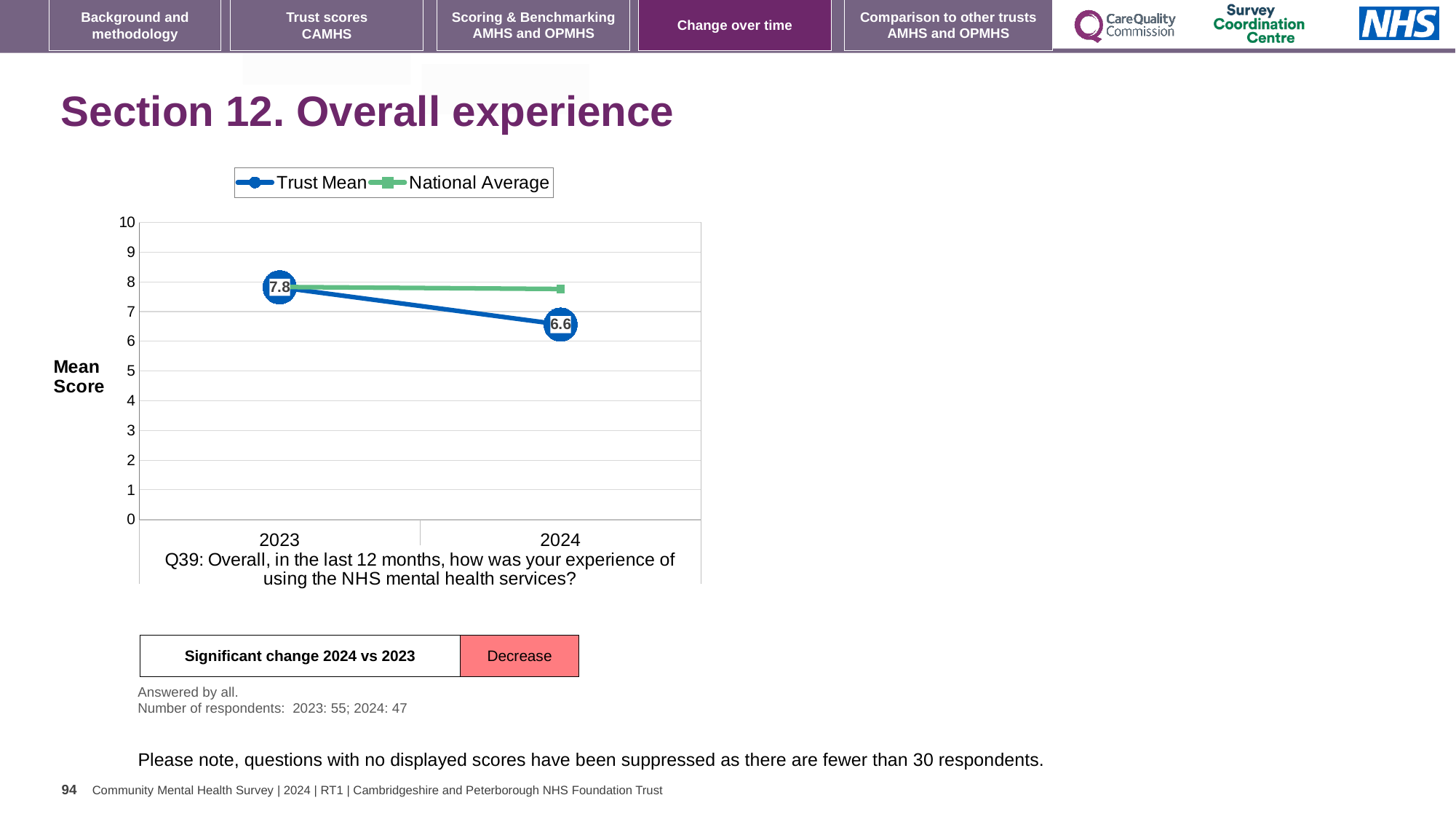
By how much did the Trust Mean score change from 2023 to 2024? 1.2 Is the National Average value for 2024 greater or less than 7? greater How many years are plotted on the x axis of the chart? 2 Which year has the higher Trust Mean score, 2023 or 2024? 2023 What does the 'Significant change 2024 vs 2023' box below the chart say? Decrease In 2024, which is higher: the Trust Mean or the National Average? National Average What kind of chart is shown on the slide? line chart What is the Trust Mean score for 2023? 7.8 What is the Trust Mean score for 2024? 6.6 Does the Trust Mean rise or fall from 2023 to 2024? fall Is the Trust Mean value for 2024 greater or less than 7? less How many series does the chart legend list? 2